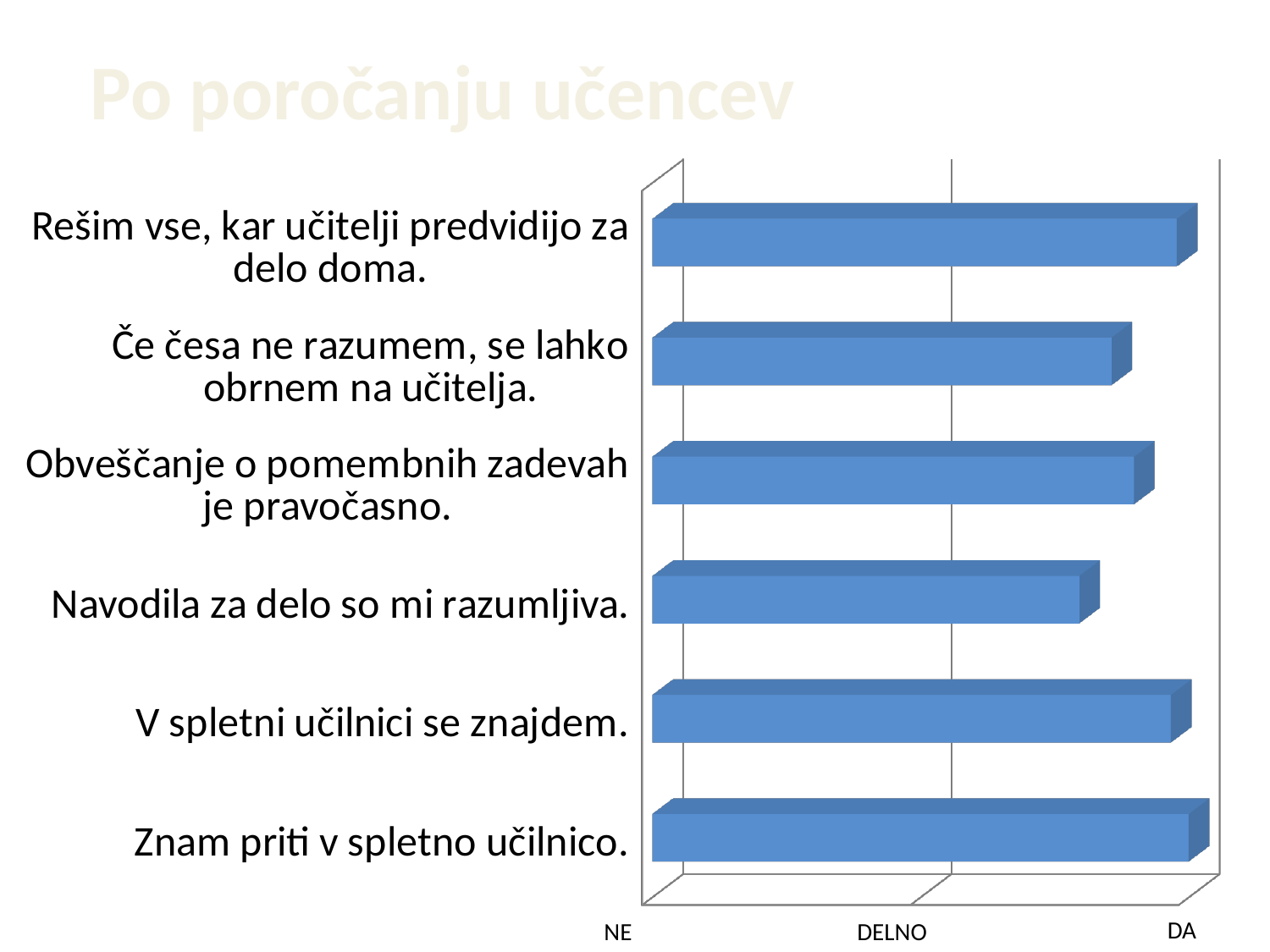
What are the three labels shown on the horizontal axis of the chart? NE, DELNO, DA Which bar is longer: "Rešim vse, kar učitelji predvidijo za delo doma." or "Če česa ne razumem, se lahko obrnem na učitelja."? Rešim vse, kar učitelji predvidijo za delo doma. What kind of chart is shown on the slide? bar chart Which statement has the shortest bar in the chart? Navodila za delo so mi razumljiva. Which bar is longer: "Obveščanje o pomembnih zadevah je pravočasno." or "Navodila za delo so mi razumljiva."? Obveščanje o pomembnih zadevah je pravočasno. How many statements (categories) are plotted in the chart? 6 Which statement has the longest bar in the chart? Znam priti v spletno učilnico. What is the title of the slide containing the chart? Po poročanju učencev Which bar is longer: "V spletni učilnici se znajdem." or "Navodila za delo so mi razumljiva."? V spletni učilnici se znajdem.